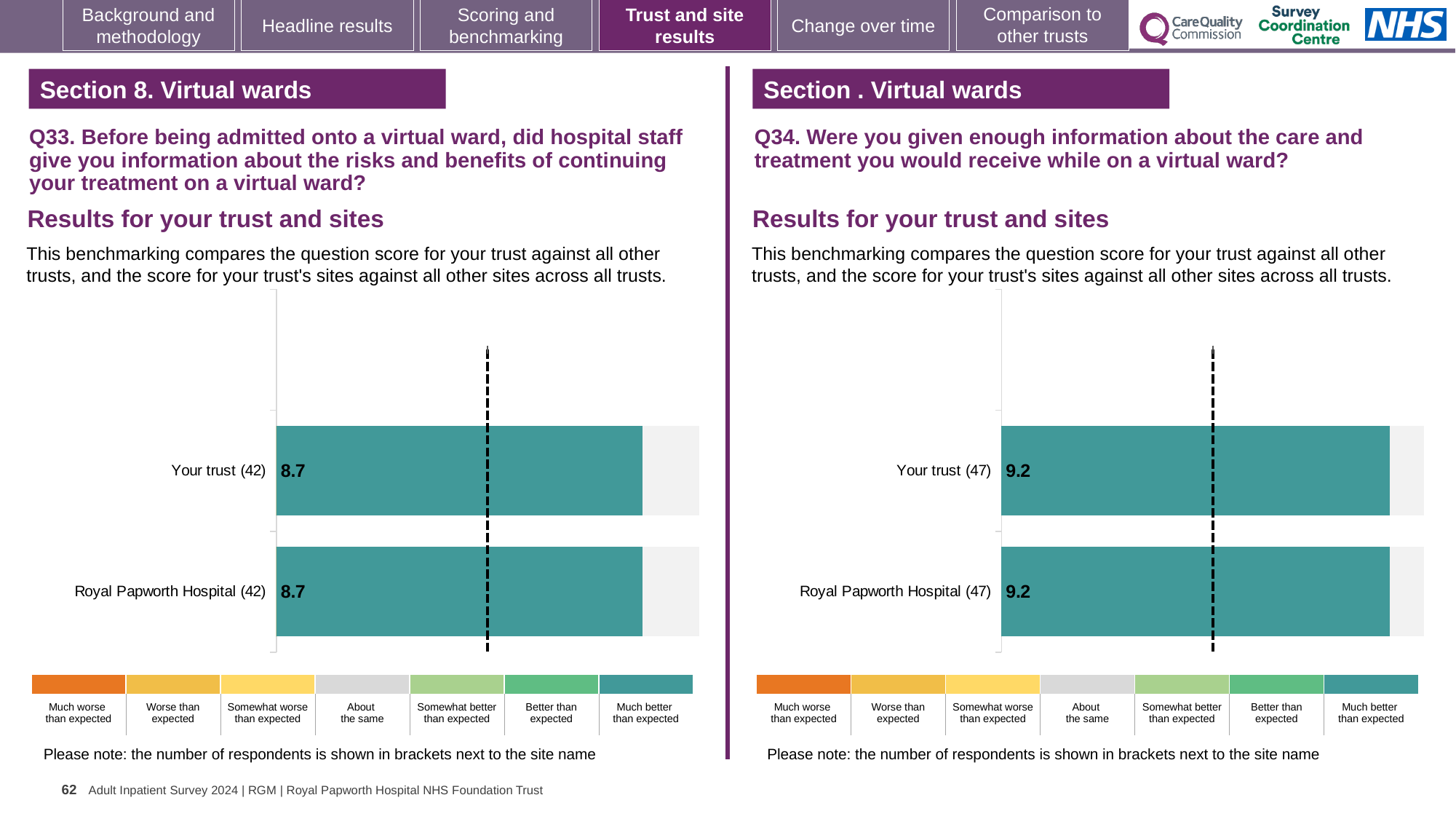
What type of chart is used for the Q33 results on the left? Bar chart In the Q33 chart on the left, how many respondents are shown in brackets for Your trust? 42 In the Q34 chart on the right, what is the score for Royal Papworth Hospital? 9.2 In the Q34 chart on the right, what is the difference between the score for Your trust and the score for Royal Papworth Hospital? 0 How many bars are plotted in the Q33 chart on the left? 2 In the Q34 chart on the right, which benchmark category does the colour of the bars correspond to according to the legend? Much better than expected In the Q33 chart on the left, what is the score for Royal Papworth Hospital? 8.7 In the Q33 chart on the left, what is the score for Your trust? 8.7 In the Q34 chart on the right, how many respondents are shown in brackets for Royal Papworth Hospital? 47 In the Q34 chart on the right, what is the score for Your trust? 9.2 How many bars are plotted in the Q34 chart on the right? 2 In the Q33 chart on the left, what is the difference between the score for Your trust and the score for Royal Papworth Hospital? 0